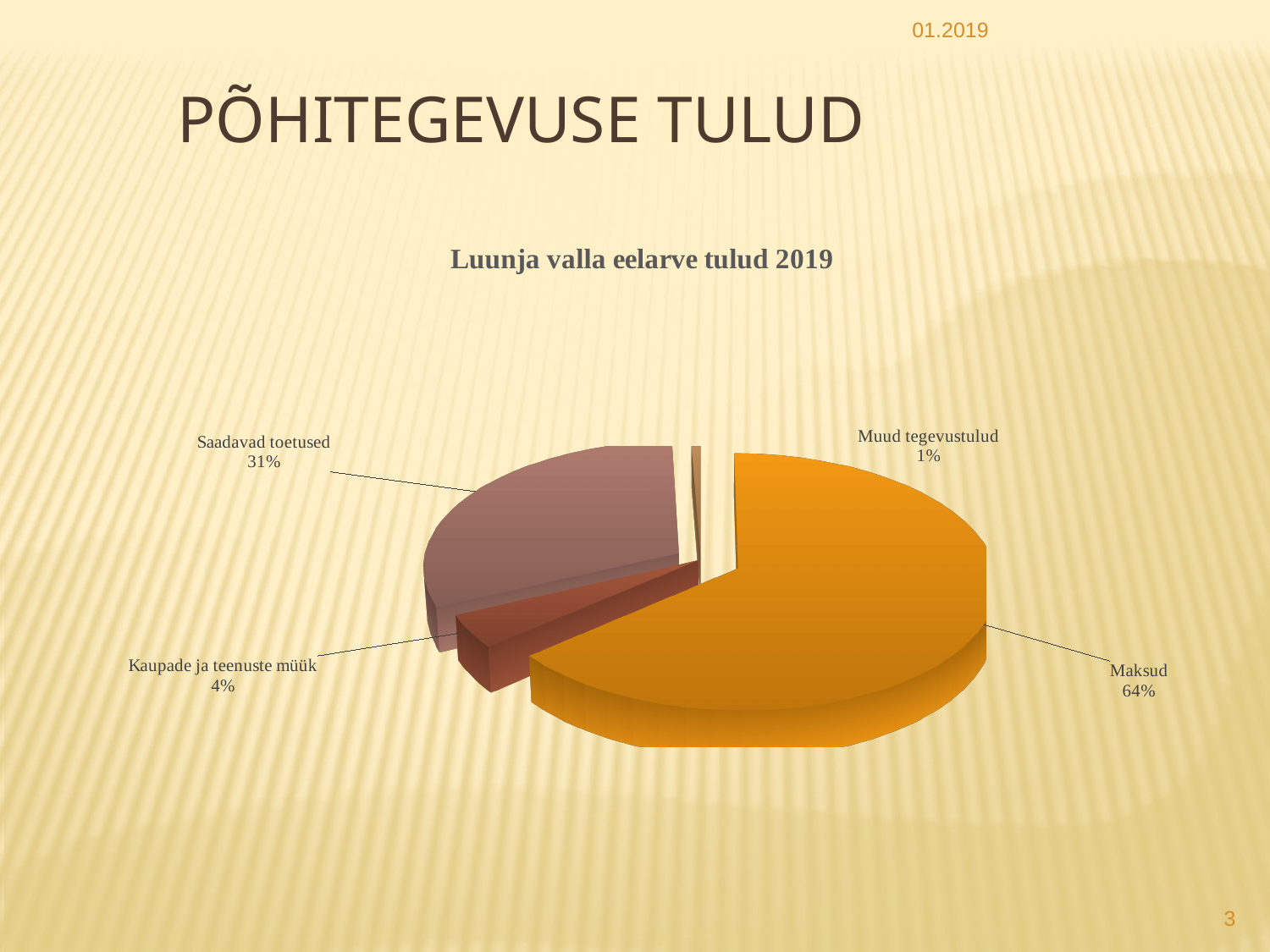
What is the value shown for Kaupade ja teenuste müük? 4% What share of the pie does Saadavad toetused represent? 31% Which category has the largest share of the pie? Maksud Which category has the smallest share of the pie? Muud tegevustulud What is the title of the chart? Luunja valla eelarve tulud 2019 Which is larger, Saadavad toetused or Kaupade ja teenuste müük? Saadavad toetused How many categories are shown in the pie chart? 4 What is the difference in percentage points between Maksud and Saadavad toetused? 33 What is the difference in percentage points between Kaupade ja teenuste müük and Muud tegevustulud? 3 What share of the pie does Maksud represent? 64% What is the value shown for Muud tegevustulud? 1% What kind of chart is shown on the slide? Pie chart